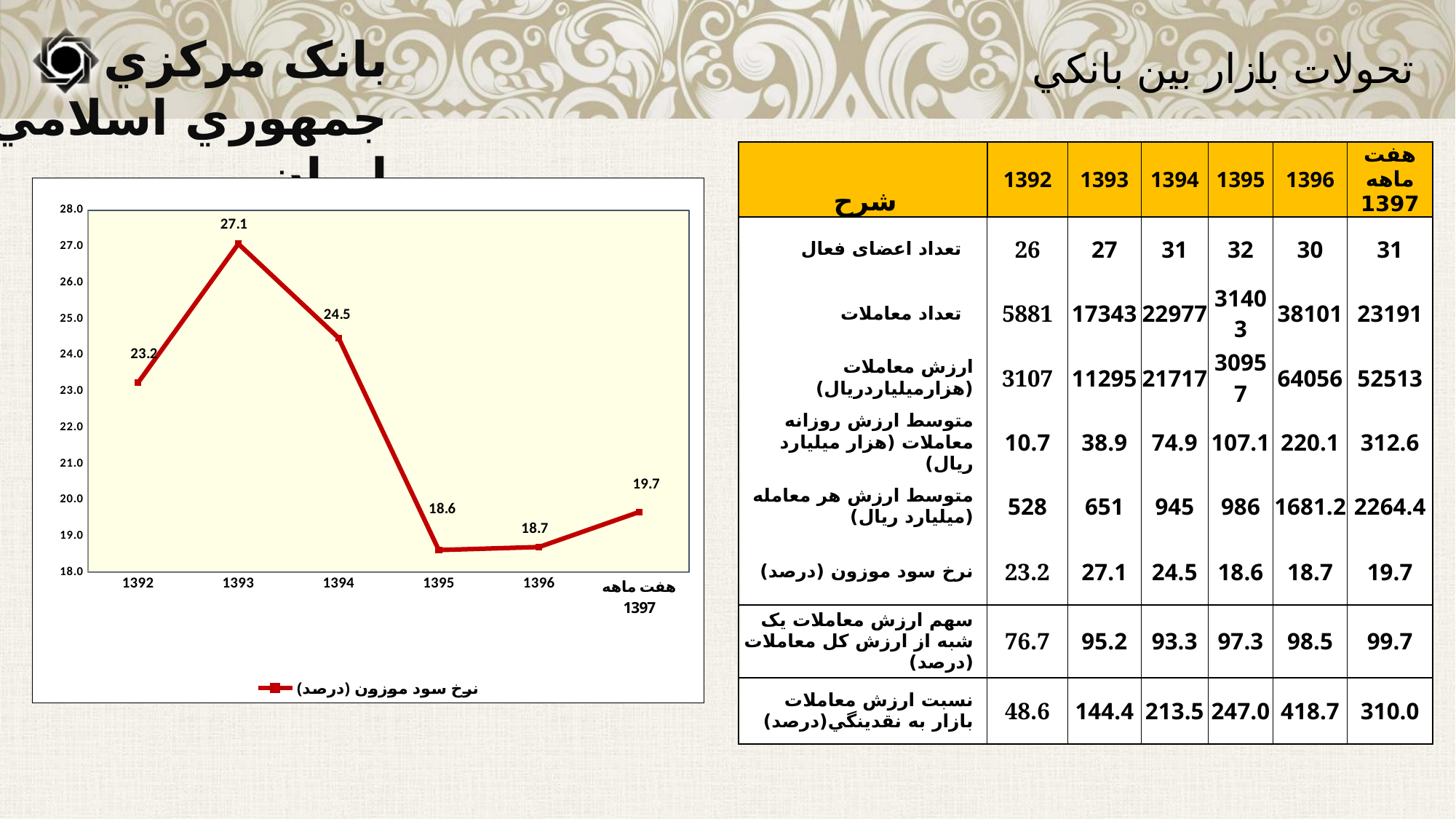
What is the value of نرخ سود موزون (درصد) for هفت ماهه 1397? 19.7 What is the value of نرخ سود موزون (درصد) for 1395? 18.6 Which year has the highest value in the chart? 1393 What is the value of نرخ سود موزون (درصد) for 1392? 23.2 Does the value rise or fall from 1394 to 1395? fall Which is larger, the value for 1392 or the value for 1394? 1394 What is the legend entry of the plotted series? نرخ سود موزون (درصد) How many data points are plotted on the line? 6 Which year has the lowest value in the chart? 1395 What type of chart is shown on the slide? line chart How many series does the legend list? 1 What is the difference between the values for 1393 and 1394? 2.6